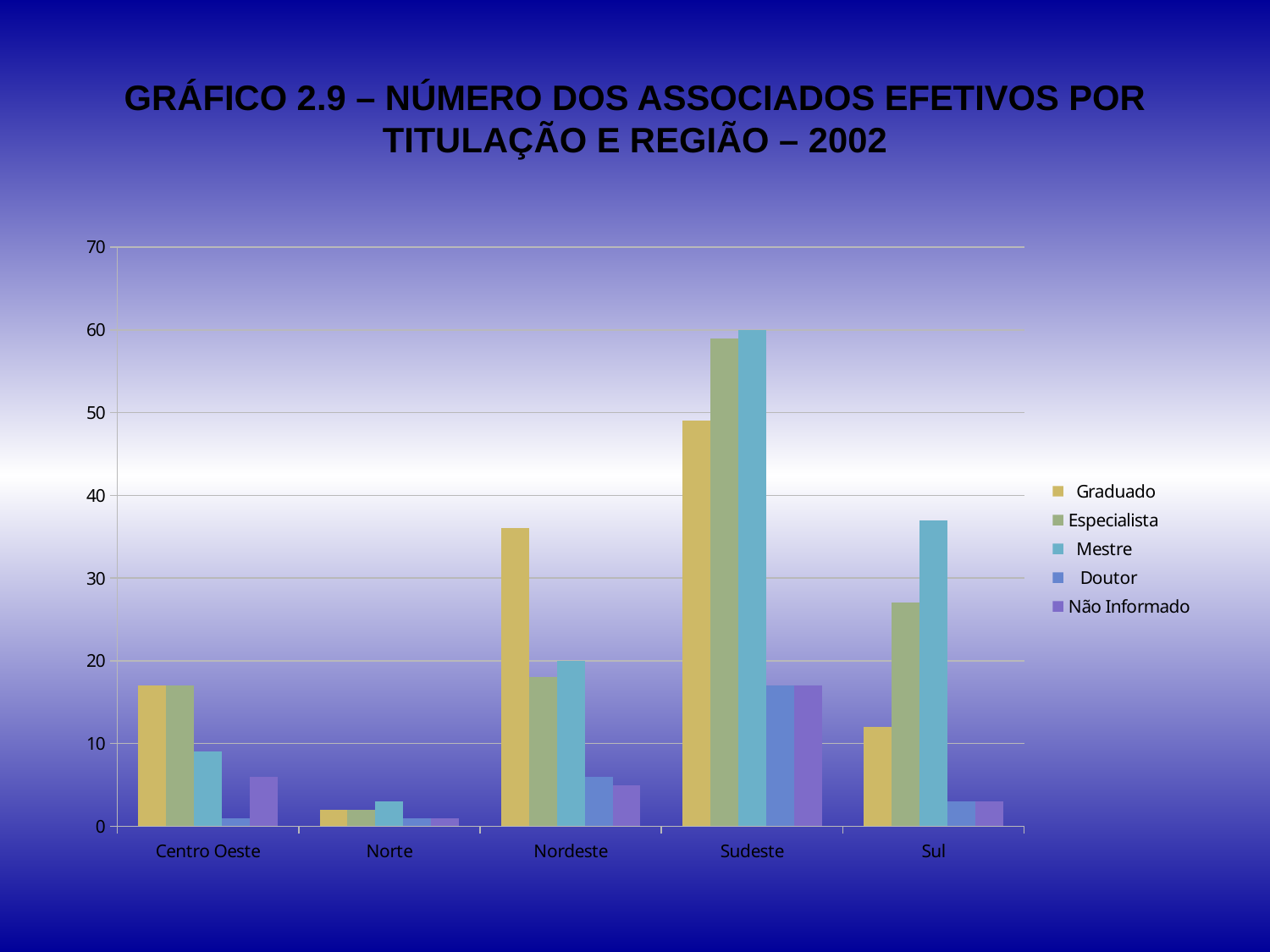
Is the value for Mestre in Sul greater or less than 30? greater Is the value for Graduado in Sudeste greater or less than 40? greater Is the value for Graduado in Nordeste greater or less than 30? greater How many series does the legend list? 5 Which series has the highest value in Nordeste? Graduado How many regions are shown on the x axis? 5 In Sul, which is larger: Mestre or Especialista? Mestre Which region has the lowest value for Mestre? Norte What kind of chart is shown on the slide? bar chart Which is larger: Doutor in Sudeste or Doutor in Nordeste? Sudeste Which region has the highest value for Graduado? Sudeste